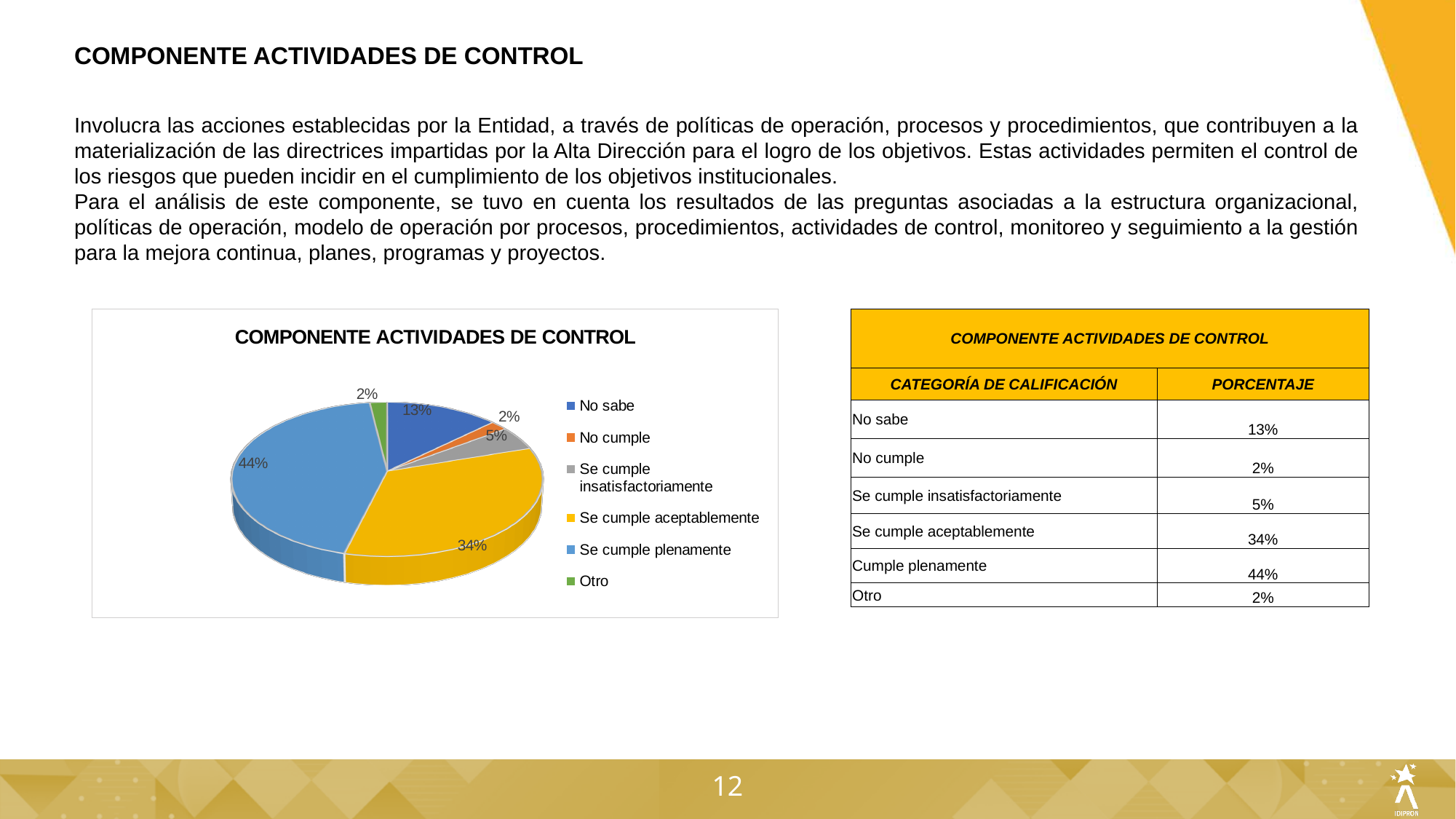
What is the difference between the 'Se cumple plenamente' and 'Se cumple aceptablemente' shares? 10% What is the title of the chart? COMPONENTE ACTIVIDADES DE CONTROL What percentage does the 'Se cumple insatisfactoriamente' slice represent? 5% What percentage does the 'Se cumple aceptablemente' slice represent? 34% Which is larger, the 'No sabe' share or the 'Se cumple insatisfactoriamente' share? No sabe Which category has the largest share of the pie? Se cumple plenamente What percentage does the 'Se cumple plenamente' slice represent? 44% What percentage does the 'No cumple' slice represent? 2% What percentage does the 'No sabe' slice represent? 13% What type of chart is shown on the slide? Pie chart How many categories does the legend list? 6 What colour is the 'Se cumple aceptablemente' slice? Yellow